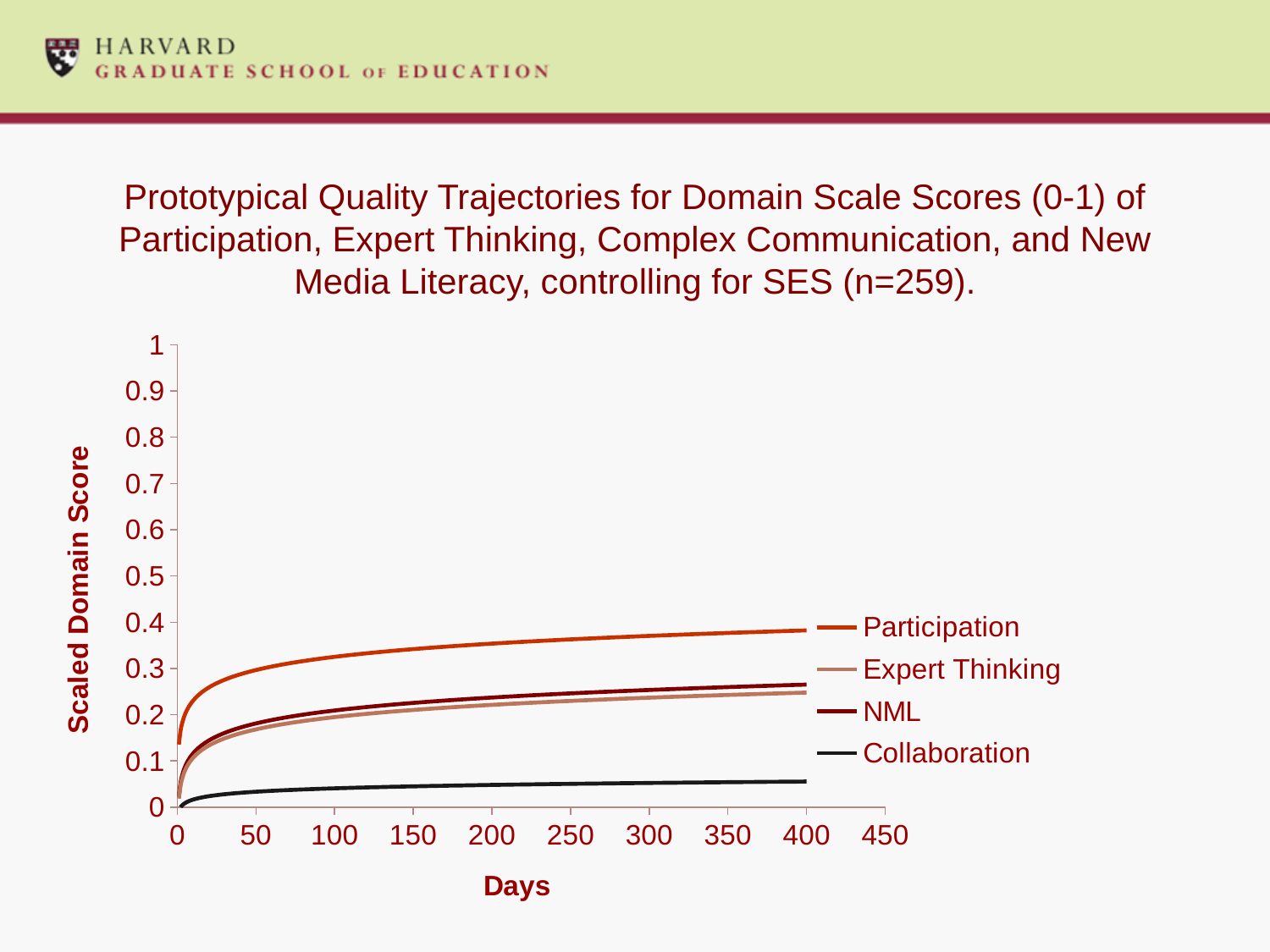
What is the label of the vertical axis? Scaled Domain Score Which series has the larger scaled domain score at 200 days, Expert Thinking or Collaboration? Expert Thinking Which series has the larger scaled domain score at 400 days, Participation or Collaboration? Participation What kind of chart is shown on the slide? line chart Is the value for Participation at 400 days greater or less than 0.4? less Which series has the lowest scaled domain score across the days shown? Collaboration Is the value for NML at 400 days greater or less than 0.2? greater Is the value for Collaboration at 400 days greater or less than 0.1? less Do the scaled domain scores rise or fall as the number of days increases? rise How many series does the legend list? 4 Which series has the highest scaled domain score at 400 days? Participation